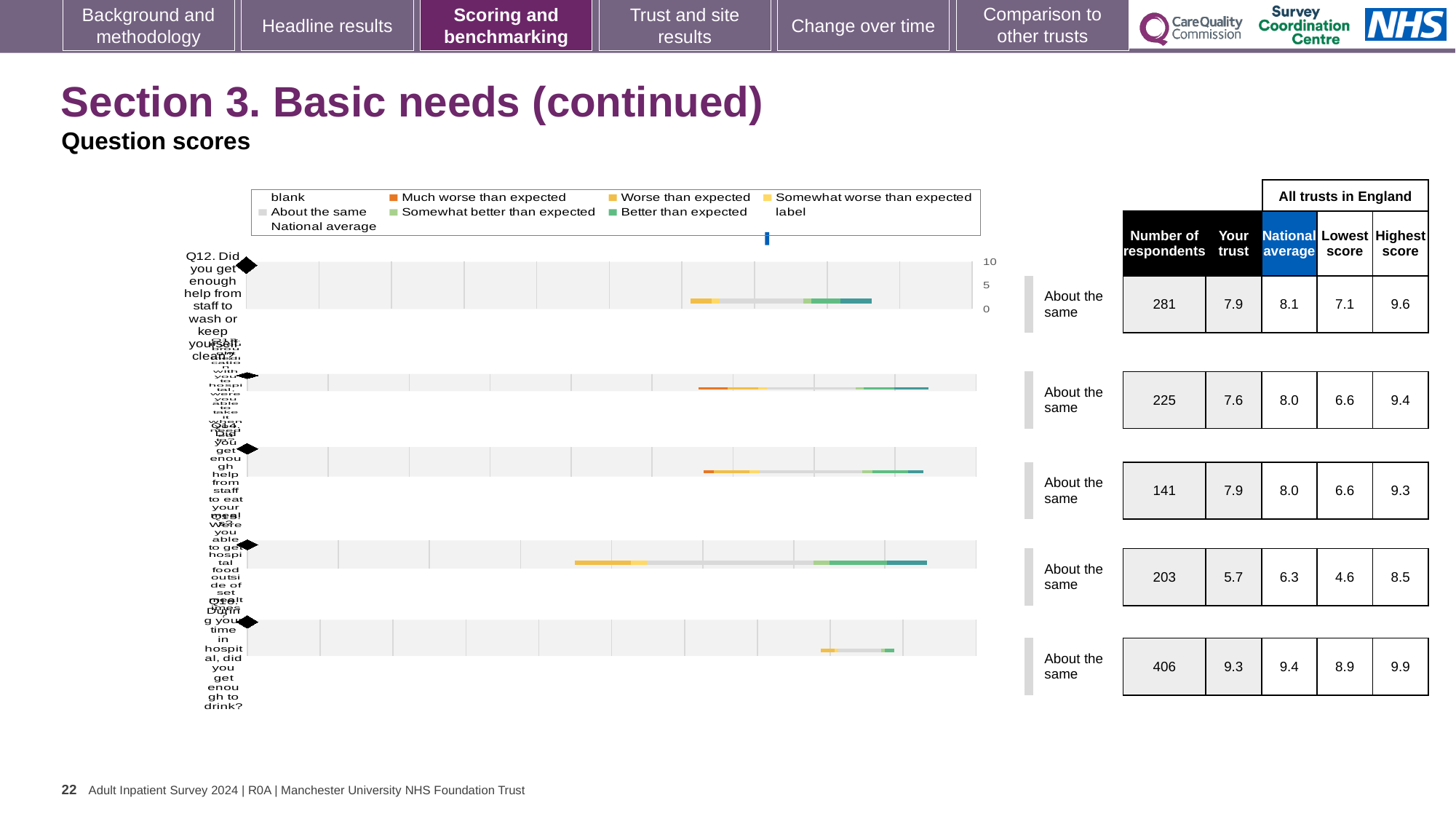
For Q12, which is larger: the 'Your trust' score or the national average? National average (8.1) What kind of chart is used to show the question scores on this slide? bar chart Which question has the highest 'Your trust' score in the table? Q16 (9.3) According to the table, what is the 'Your trust' score for Q12 (help from staff to wash or keep yourself clean)? 7.9 How many survey questions (rows) are plotted in the chart? 5 Which question has the lowest 'Your trust' score in the table? Q15 (5.7) According to the table, how many respondents answered Q16 (did you get enough to drink)? 406 What colour does the legend use for 'Much worse than expected'? Orange What benchmark category is shown for every question on this slide? About the same According to the table, what is the highest score among all trusts in England for Q14 (help from staff to eat your meals)? 9.3 According to the table, what is the lowest score among all trusts in England for the second question (Q13)? 6.6 For Q15 (hospital food outside of set meal times), what is the difference between the national average and the 'Your trust' score? 0.6